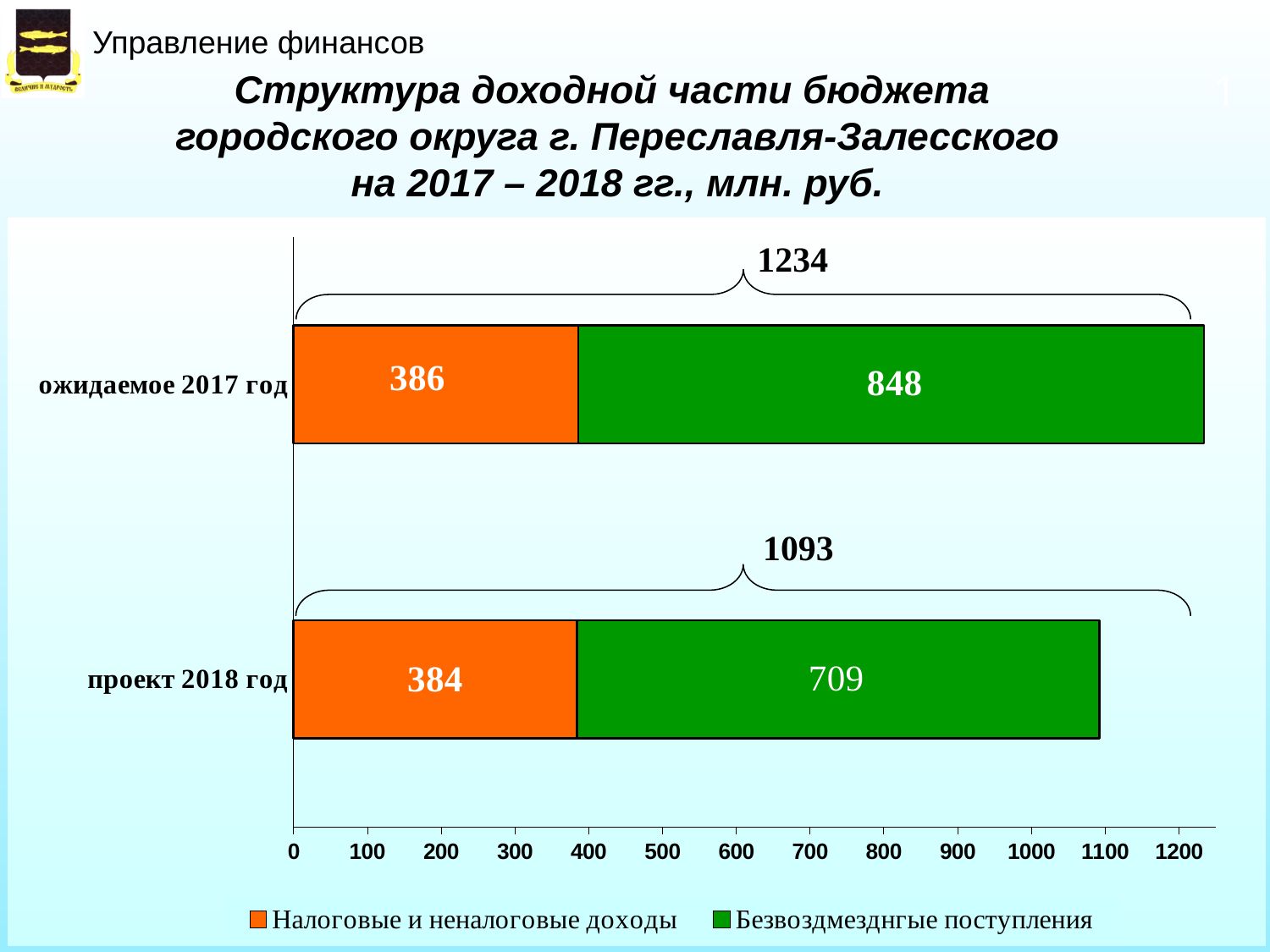
How many series does the legend list? 2 What is the total of the stacked bar for ожидаемое 2017 год? 1234 What is the value of Налоговые и неналоговые доходы for ожидаемое 2017 год? 386 What is the value of Безвоздмезднгые поступления for проект 2018 год? 709 How many categories are shown on the chart? 2 Which colour represents Безвоздмезднгые поступления in the legend? Green Which is larger: Безвоздмезднгые поступления for ожидаемое 2017 год or for проект 2018 год? ожидаемое 2017 год What kind of chart is shown on the slide? Stacked bar chart What is the total of the stacked bar for проект 2018 год? 1093 What is the value of Безвоздмезднгые поступления for ожидаемое 2017 год? 848 What is the difference between Безвоздмезднгые поступления for ожидаемое 2017 год and for проект 2018 год? 139 What is the value of Налоговые и неналоговые доходы for проект 2018 год? 384